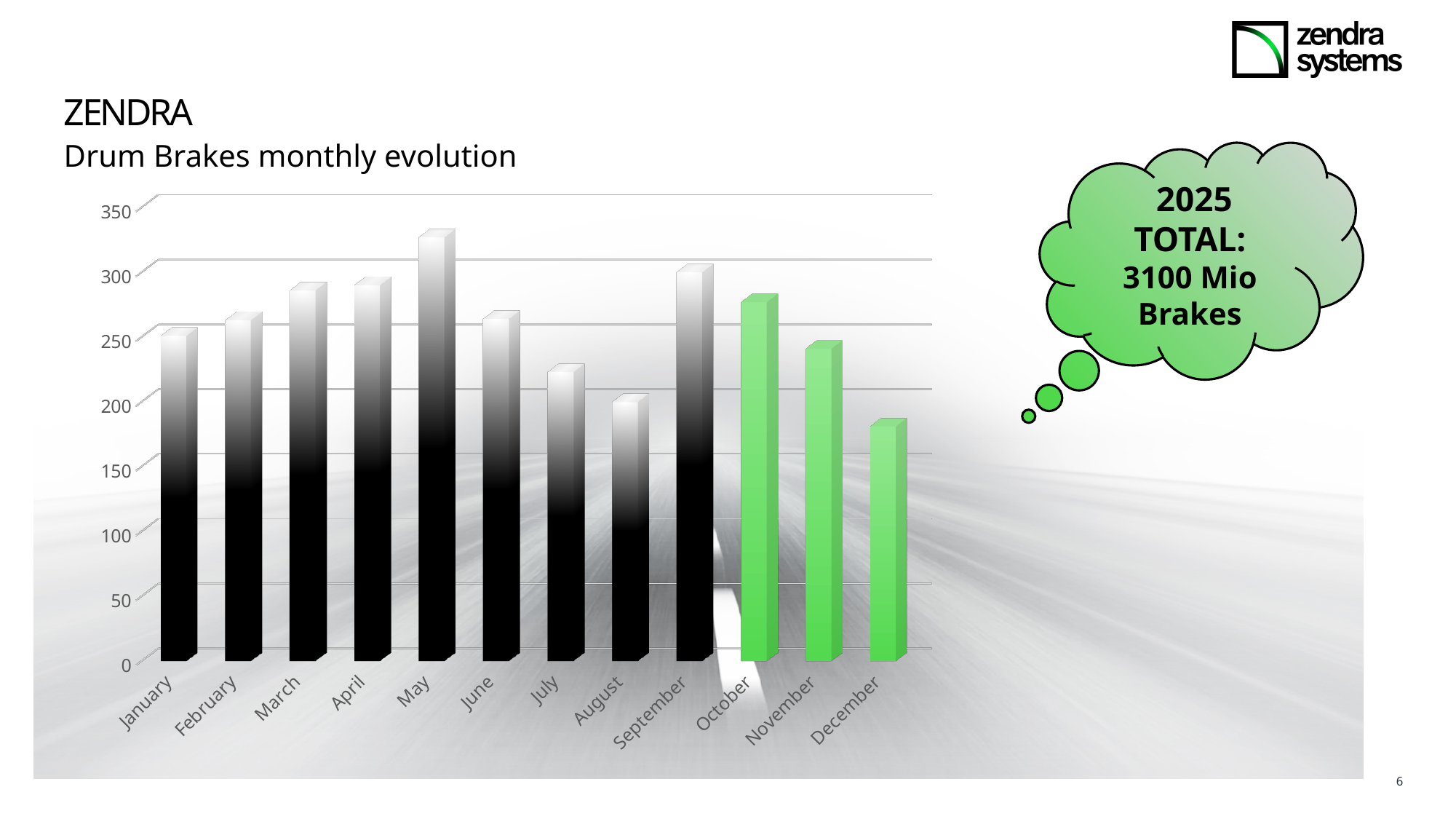
Which is larger, the value for September or the value for August? September Which months are shown with green bars? October, November, December Is the value for December greater or less than 200? less Is the value for March greater or less than 250? greater Which month has the highest bar? May How many months are plotted on the chart? 12 Which month has the lowest bar? December Is the value for July greater or less than 250? less What kind of chart is shown on the slide? bar chart Which is larger, the value for December or the value for October? October